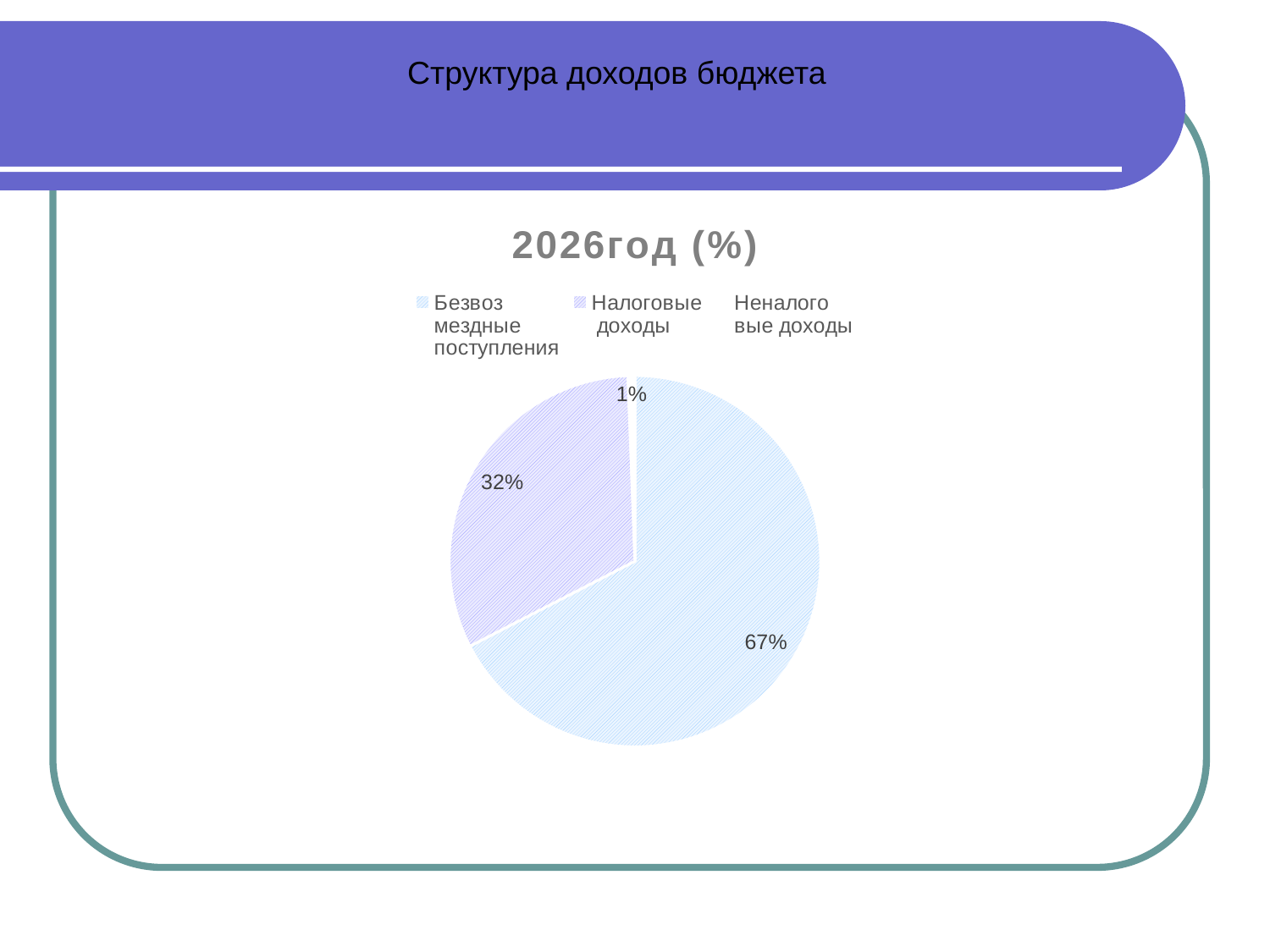
What share of the pie does Неналоговые доходы take? 1% What is the chart's title? 2026год (%) What type of chart is shown on the slide? pie chart Which category has the smallest slice of the pie? Неналоговые доходы Which is larger, the slice for Налоговые доходы or the slice for Неналоговые доходы? Налоговые доходы What is the difference in percentage points between Налоговые доходы and Неналоговые доходы? 31 Which category has the largest slice of the pie? Безвозмездные поступления What is the difference in percentage points between Безвозмездные поступления and Налоговые доходы? 35 How many slices does the pie chart have? 3 What share of the pie does Налоговые доходы take? 32% How many entries does the legend list? 3 What share of the pie does Безвозмездные поступления take? 67%